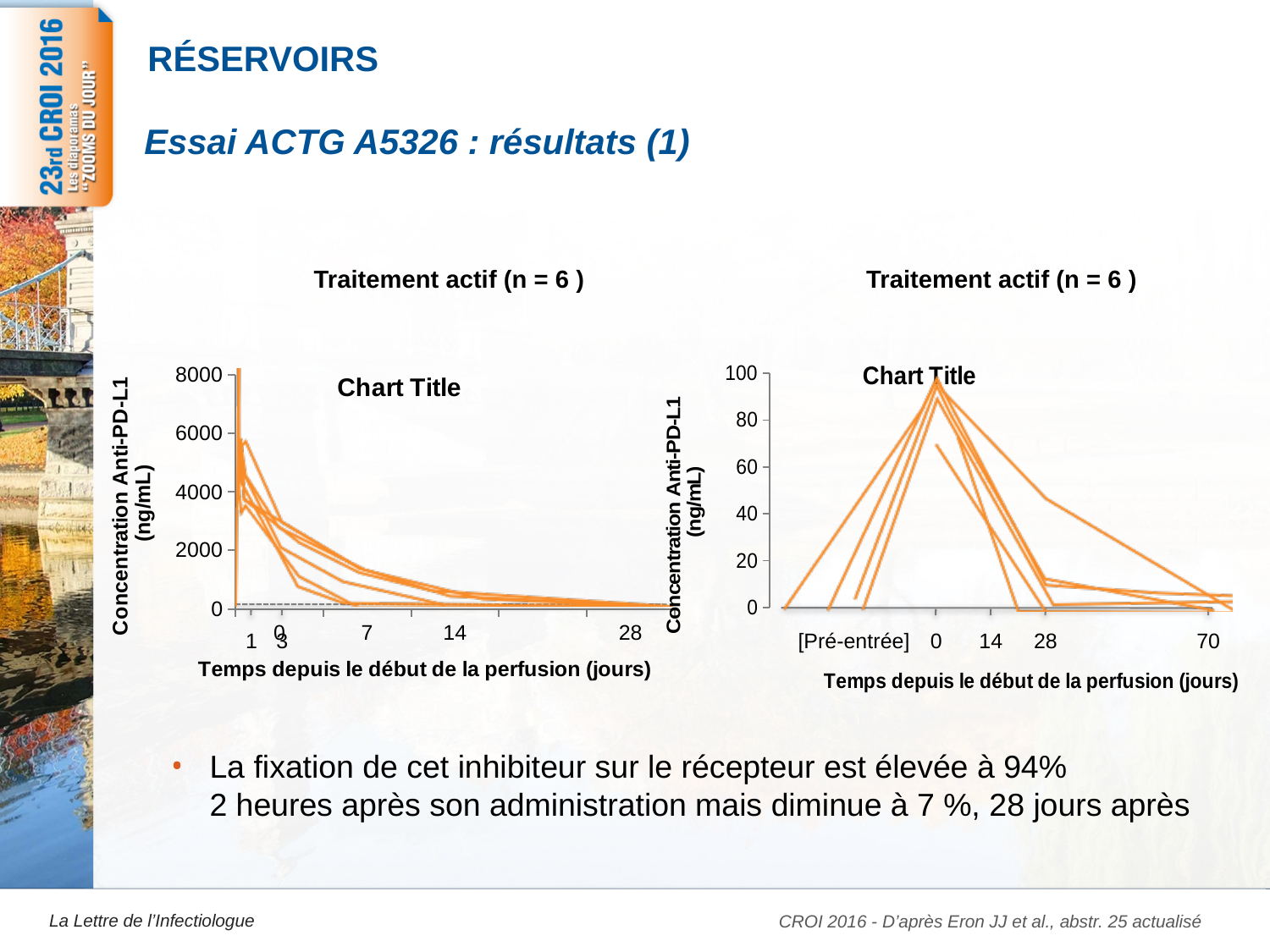
On the left chart, is the value of the lines at day 28 greater or less than 2000? less On the right chart, do the values rise or fall between [Pré-entrée] and day 0? rise On the left chart, is the value of the lines at day 14 greater or less than 2000? less On the right chart, what is the label of the x axis? Temps depuis le début de la perfusion (jours) What kind of chart is the right chart on the slide? line chart On the left chart, what is the label of the y axis? Concentration Anti-PD-L1 (ng/mL) What is the highest tick value shown on the y axis of the left chart? 8000 On the right chart, are the values at day 70 greater or less than 20? less On the left chart, do the values rise or fall along the x axis from day 0 to day 28? fall On the right chart, do the values rise or fall between day 0 and day 28? fall What kind of chart is the left chart on the slide? line chart